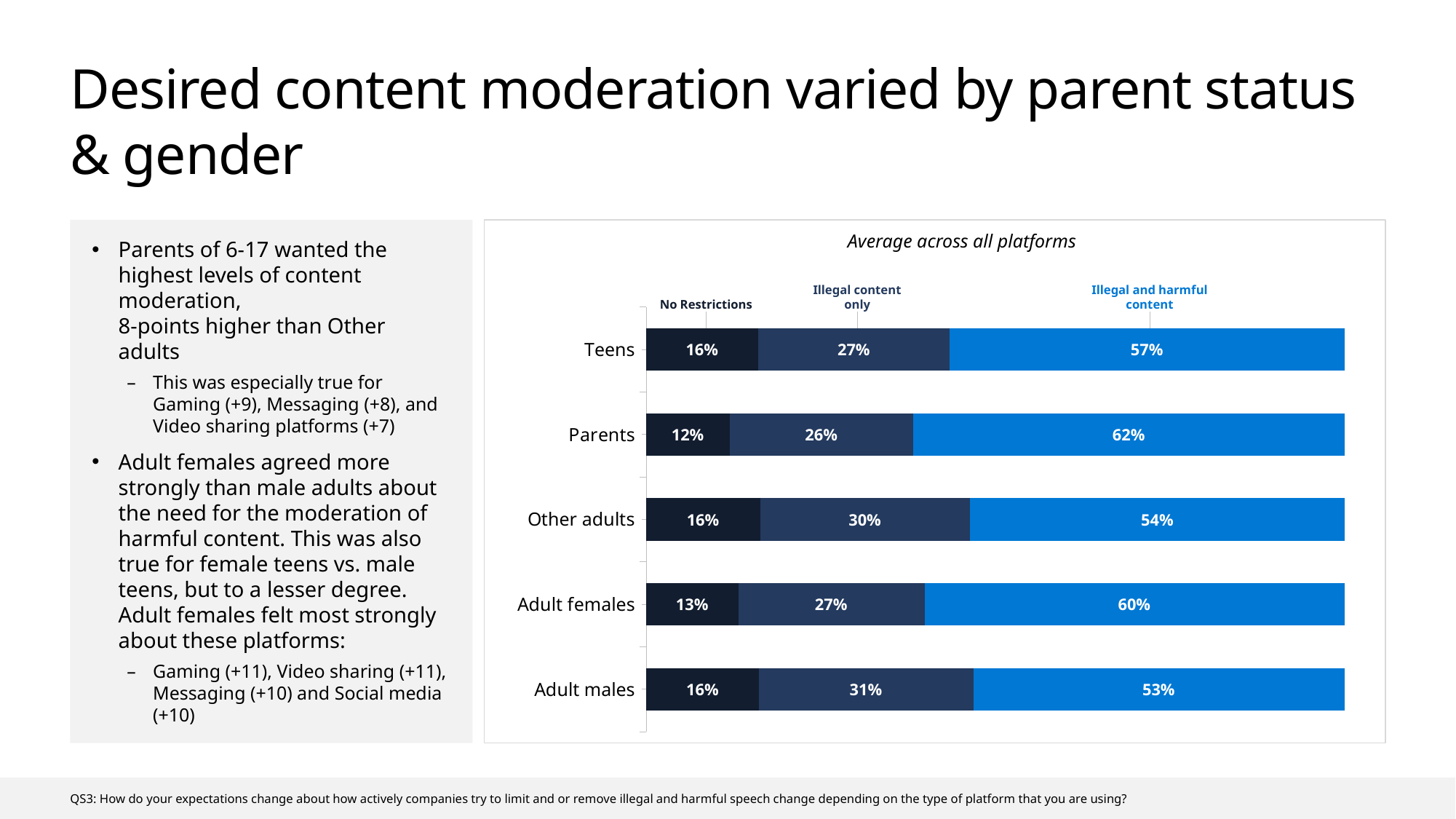
Which is larger: the 'Illegal and harmful content' value for Adult females or for Adult males? Adult females Which group has the highest 'Illegal and harmful content' value? Parents What percentage of Parents want moderation of illegal and harmful content? 62% What is the title of the chart? Average across all platforms What type of chart is shown? Stacked bar chart How many series does the chart show? 3 Which group has the lowest 'Illegal and harmful content' value? Adult males What is the difference between the 'Illegal and harmful content' values for Parents and Other adults? 8 percentage points Which group has the lowest 'No Restrictions' value? Parents How many groups are shown on the chart? 5 What is the 'No Restrictions' value for Adult females? 13% What is the 'Illegal content only' value for Adult males? 31%